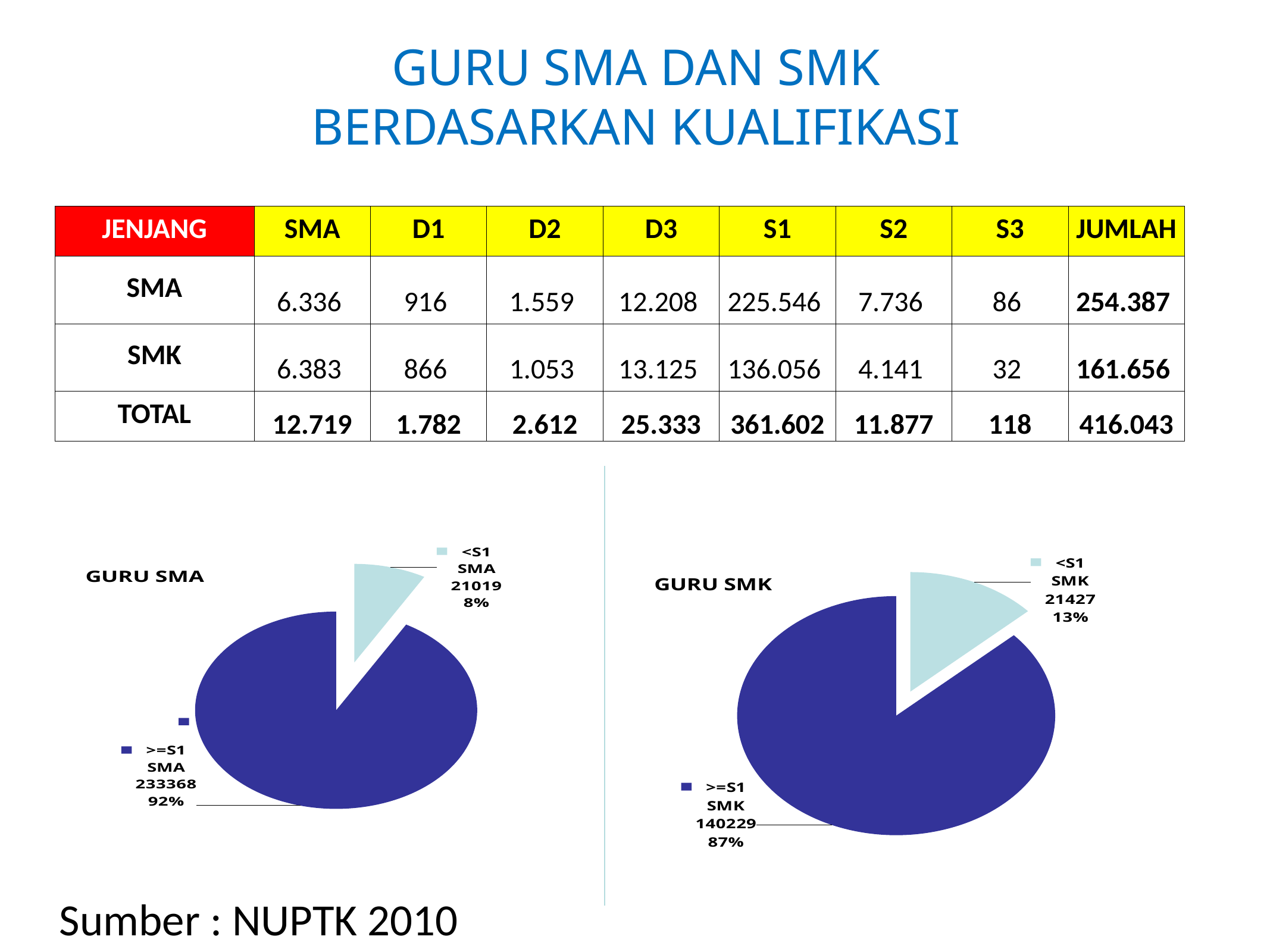
How many slices does the GURU SMK pie chart have? 2 In the GURU SMA pie chart, what share of the pie is <S1 SMA? 8% In the GURU SMK pie chart, what is the value for <S1 SMK? 21427 In the GURU SMK pie chart, what is the value for >=S1 SMK? 140229 In the GURU SMA pie chart, what is the difference between the >=S1 SMA and <S1 SMA values? 212349 In the GURU SMK pie chart, which slice is the largest? >=S1 SMK In the GURU SMA pie chart, which slice is the smallest? <S1 SMA In the GURU SMA pie chart, what is the value for <S1 SMA? 21019 In the GURU SMA pie chart, what share of the pie is >=S1 SMA? 92% In the GURU SMK pie chart, what share of the pie is <S1 SMK? 13% What kind of chart is the GURU SMA chart? pie chart In the GURU SMA pie chart, what is the value for >=S1 SMA? 233368